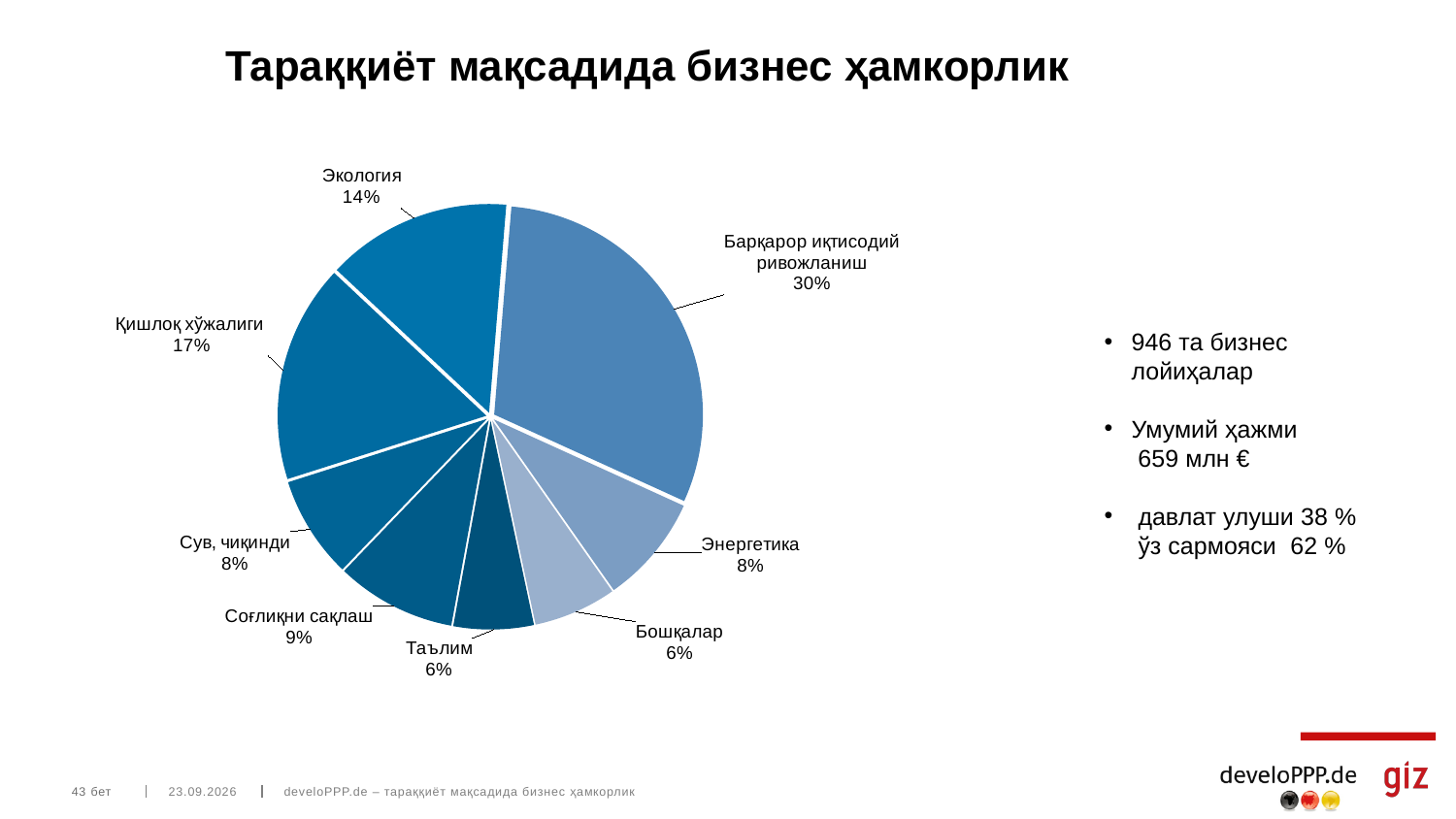
What is the difference between the shares of Барқарор иқтисодий ривожланиш and Қишлоқ хўжалиги? 13% What is the value shown for Экология? 14% Which is larger, the share for Экология or the share for Соғлиқни сақлаш? Экология What kind of chart is shown on the slide? Pie chart How many slices does the pie chart have? 8 Which category has the largest slice of the pie? Барқарор иқтисодий ривожланиш Which two categories each have a share of 6%? Бошқалар and Таълим What is the value shown for Энергетика? 8% What is the value shown for Соғлиқни сақлаш? 9% What is the difference between the shares of Қишлоқ хўжалиги and Экология? 3% What share of the pie does Барқарор иқтисодий ривожланиш have? 30% What is the value shown for Қишлоқ хўжалиги? 17%